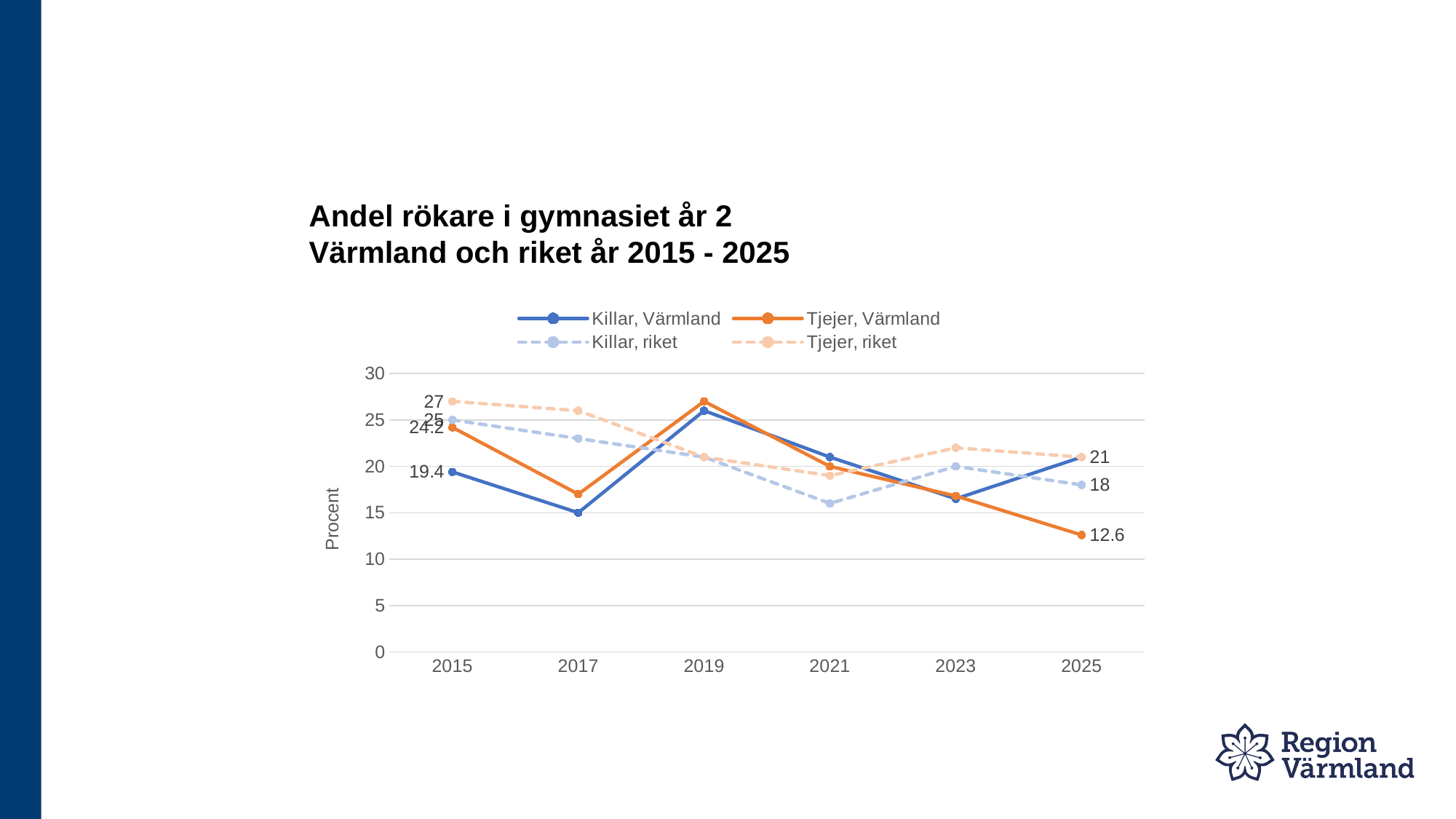
By how much did the value for Tjejer, Värmland fall from 2015 to 2025? 11.6 What is the value for Tjejer, Värmland in 2015? 24.2 What is the value for Killar, Värmland in 2015? 19.4 Is the value for Killar, Värmland in 2017 greater or less than 20? less How many series does the legend list? 4 What is the difference between Tjejer, riket and Killar, Värmland in 2015? 7.6 What kind of chart is this? line chart What is the value for Killar, riket in 2025? 18 What is the value for Tjejer, Värmland in 2025? 12.6 How many years are shown on the x axis? 6 What is the value for Tjejer, riket in 2015? 27 Which series has the lowest value in 2025? Tjejer, Värmland